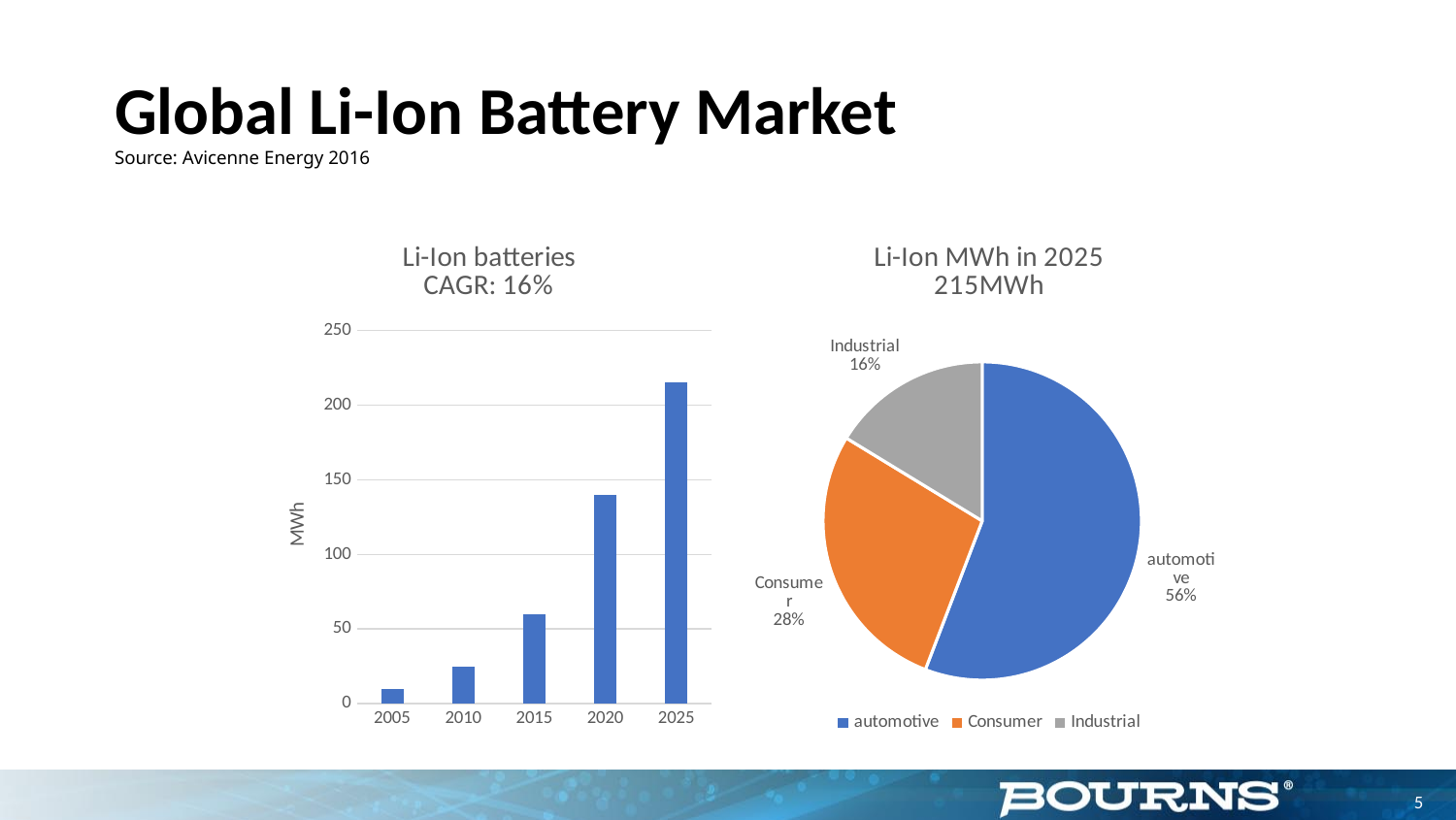
On the left chart (Li-Ion batteries CAGR: 16%), which year has the lowest value? 2005 On the left chart (Li-Ion batteries CAGR: 16%), which year has the highest value? 2025 On the left chart (Li-Ion batteries CAGR: 16%), what is the label on the y axis? MWh On the right chart (Li-Ion MWh in 2025), how many entries does the legend list? 3 On the left chart (Li-Ion batteries CAGR: 16%), is the value for 2025 greater or less than 200? greater On the left chart (Li-Ion batteries CAGR: 16%), do the values rise or fall from 2005 to 2025? rise On the right chart (Li-Ion MWh in 2025), which segment is the smallest? Industrial On the left chart (Li-Ion batteries CAGR: 16%), is the value for 2015 greater or less than 100? less On the left chart (Li-Ion batteries CAGR: 16%), what kind of chart is shown? bar chart On the left chart (Li-Ion batteries CAGR: 16%), is the value for 2020 greater or less than 100? greater On the right chart (Li-Ion MWh in 2025), what share of the pie is automotive? 56% On the left chart (Li-Ion batteries CAGR: 16%), how many years are plotted on the x axis? 5